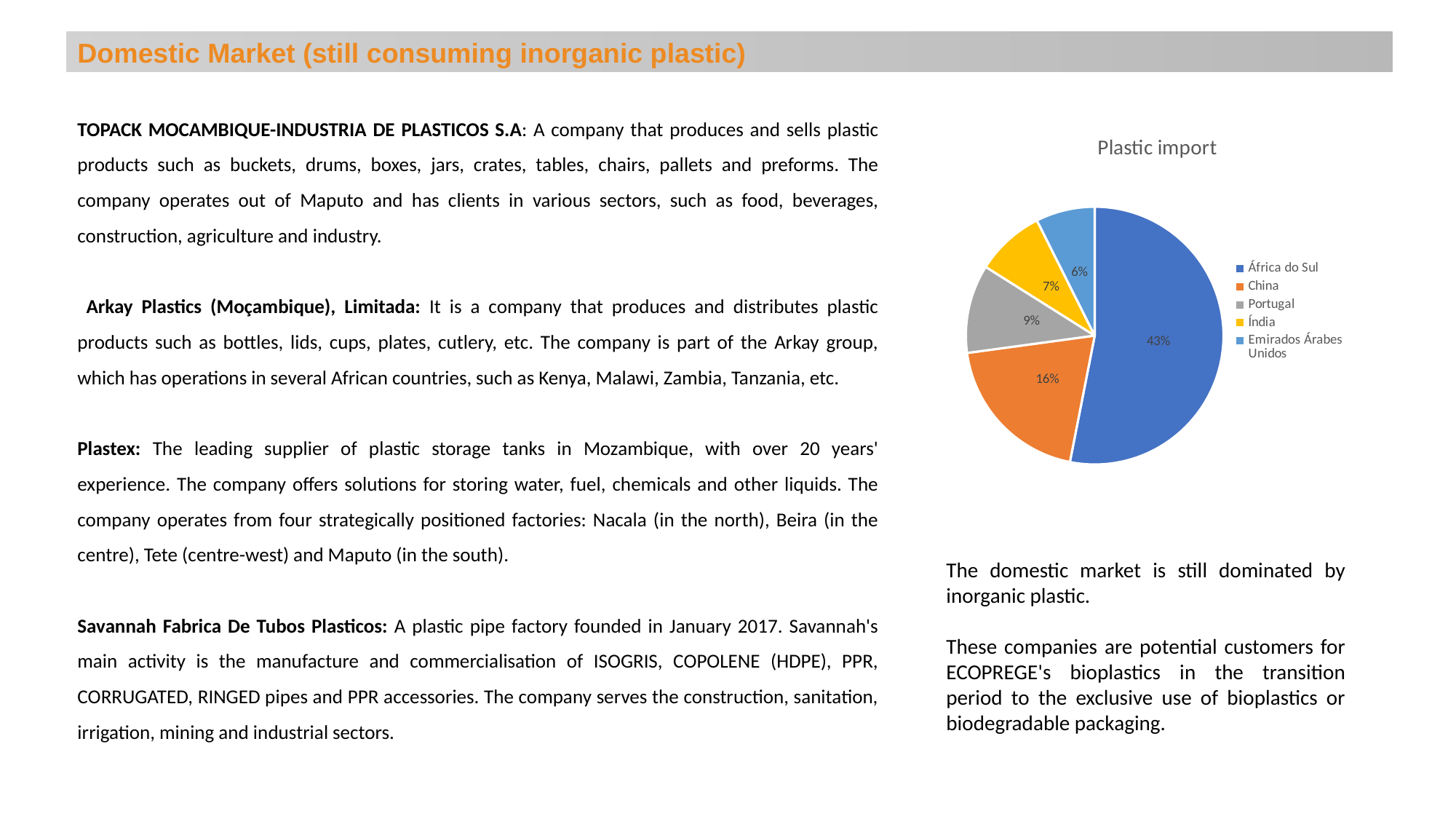
What is the title of the chart? Plastic import What is the difference in share between África do Sul and China? 27% What share of plastic imports comes from Índia? 7% How many countries are shown in the pie chart? 5 What share of plastic imports comes from África do Sul? 43% What share of plastic imports comes from Emirados Árabes Unidos? 6% What type of chart is shown on the slide? pie chart Which country has the largest share of plastic imports? África do Sul Which country has the smallest share of plastic imports? Emirados Árabes Unidos Which has a larger share of plastic imports, Portugal or Índia? Portugal